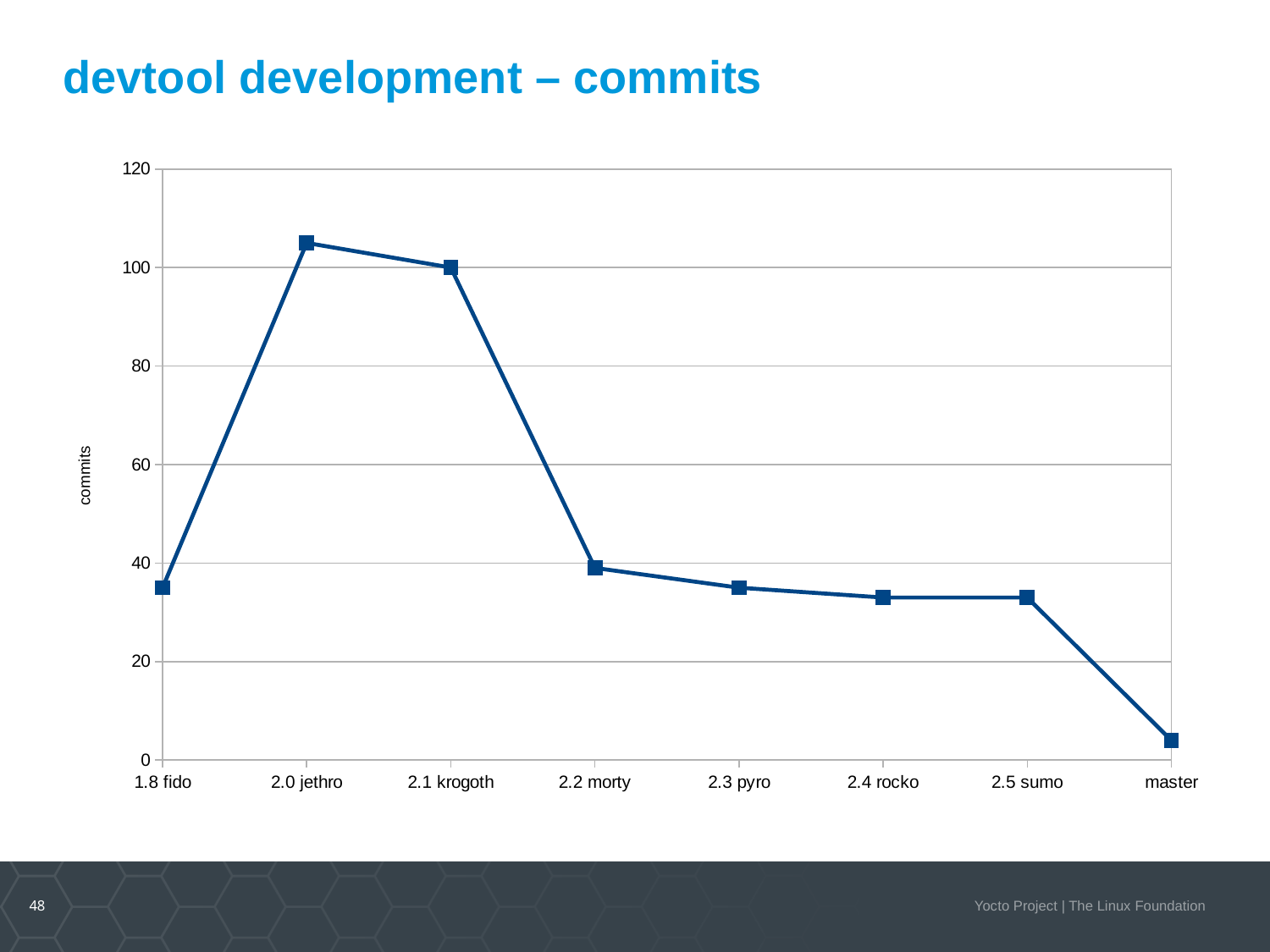
What is the number of commits for 2.1 krogoth? 100 What kind of chart is shown on the slide? line chart Is the value for 2.0 jethro greater or less than 100? greater How many releases (categories) are plotted along the x axis? 8 Which category has the lowest number of commits? master Is the value for master greater or less than 20? less What is the label on the y axis? commits Which has more commits, 1.8 fido or 2.0 jethro? 2.0 jethro Is the value for 1.8 fido greater or less than 40? less Do the commit values rise or fall from 2.1 krogoth to master? fall Which release has the highest number of commits? 2.0 jethro